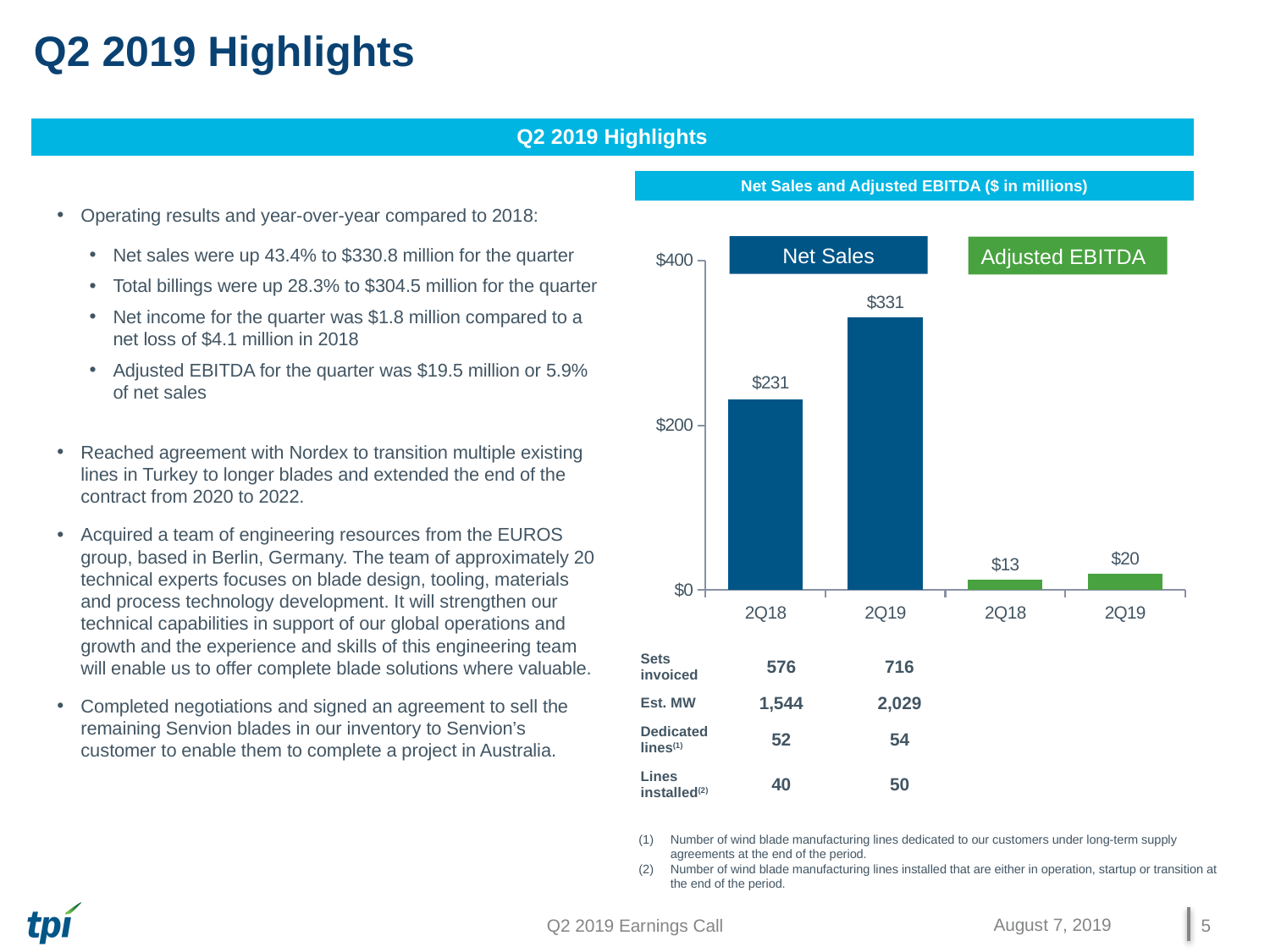
Which bar in the chart has the lowest value? Adjusted EBITDA 2Q18 What is the title of the chart on the slide? Net Sales and Adjusted EBITDA ($ in millions) What is the Net Sales value for 2Q18 in the chart? $231 What is the Net Sales value for 2Q19 in the Net Sales and Adjusted EBITDA chart? $331 Is Net Sales for 2Q18 greater or less than $200 in the chart? greater What is the difference between Adjusted EBITDA in 2Q19 and 2Q18 in the chart? $7 What is the Adjusted EBITDA value for 2Q18 in the chart? $13 By how much did Net Sales increase from 2Q18 to 2Q19 according to the chart labels? $100 Which is larger in the chart: Adjusted EBITDA for 2Q18 or for 2Q19? 2Q19 What type of chart is shown on the slide? Bar chart Which bar in the chart has the highest value? Net Sales 2Q19 What is the Adjusted EBITDA value for 2Q19 in the chart? $20